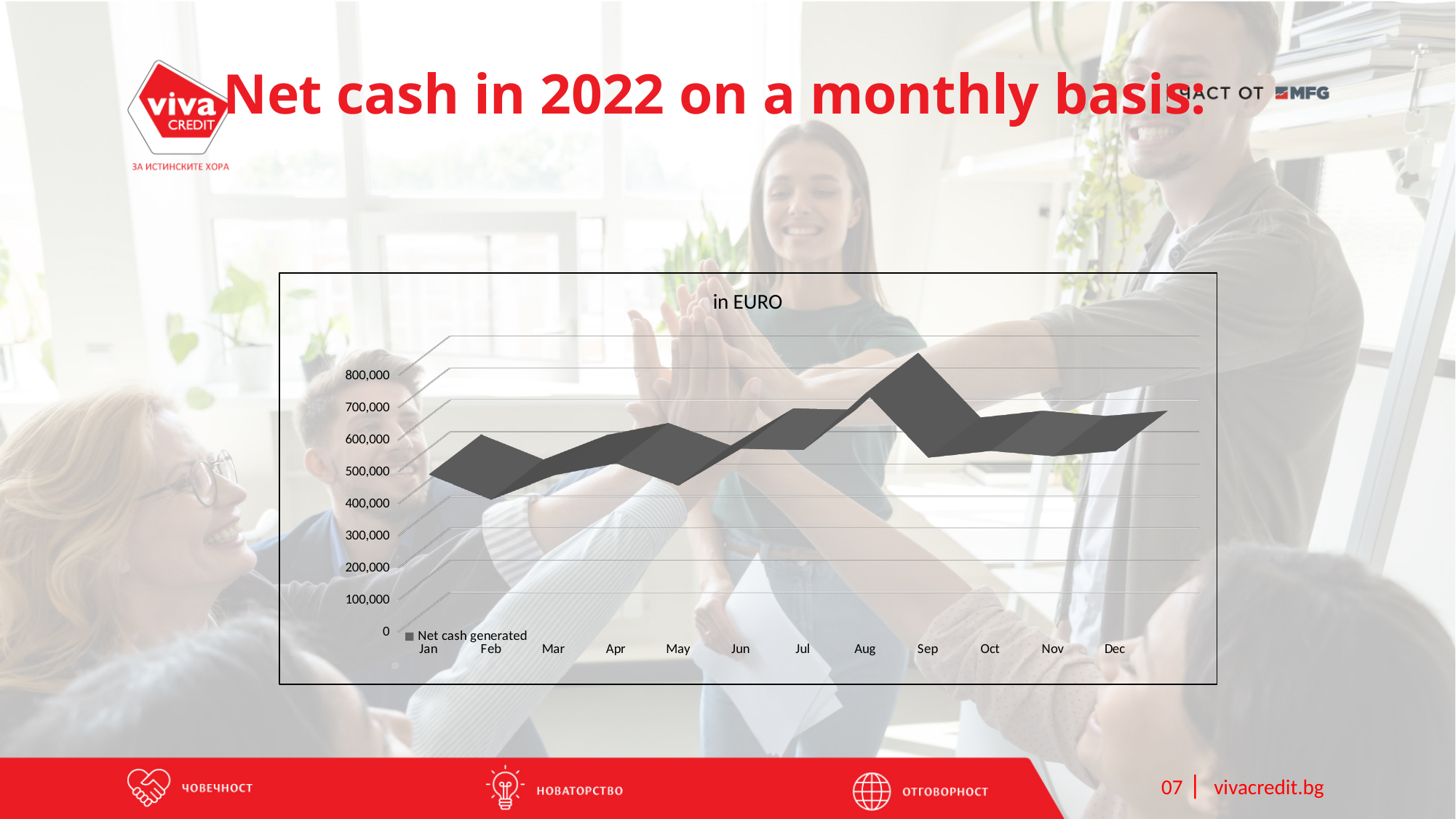
Which month has the highest net cash generated? Aug What is the name of the series shown in the chart's legend? Net cash generated Is the value for Sep greater or less than 700,000? less Which month has the larger net cash generated, Aug or Mar? Aug How many months are plotted along the x axis of the chart? 12 How many series does the chart's legend list? 1 Which month has the larger net cash generated, Sep or Feb? Sep Does the net cash generated rise or fall from Sep to Oct? rise Is the value for Feb greater or less than 600,000? less What kind of chart is shown on the slide? line chart Is the value for Aug greater or less than 600,000? greater What is the title shown above the chart? in EURO